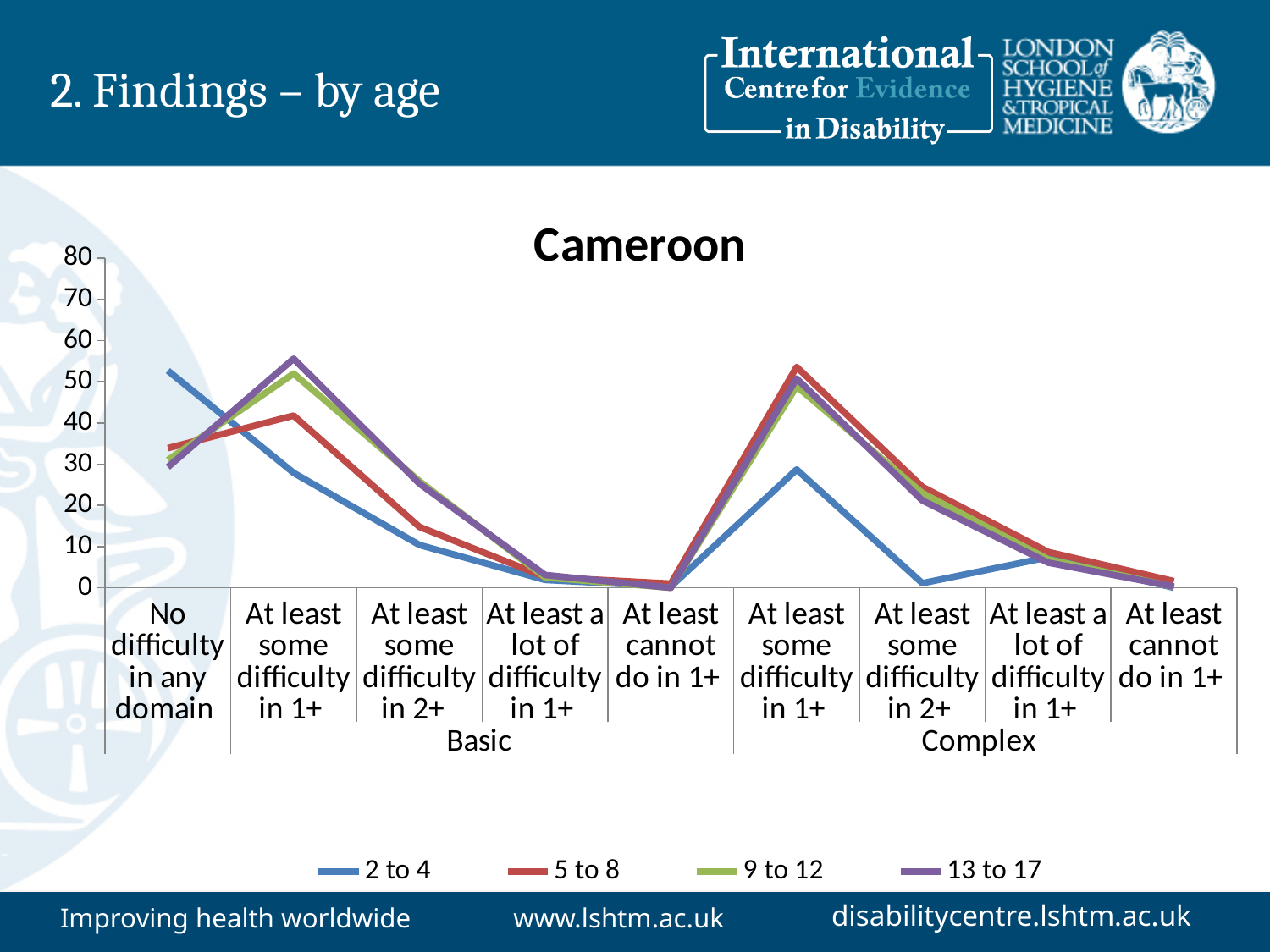
What are the two groupings labelled beneath the x-axis categories? Basic and Complex What is the title of the chart? Cameroon Which age group has the highest value at "No difficulty in any domain"? 2 to 4 Is the value for the 13 to 17 age group at "At least some difficulty in 1+" under Basic greater or less than 50? greater How many categories are shown along the x axis? 9 Which age group has the lowest value at "At least some difficulty in 1+" under Basic? 2 to 4 Is the value for the 5 to 8 age group at "At least some difficulty in 1+" under Complex greater or less than 40? greater Is the value for the 2 to 4 age group at "At least some difficulty in 1+" under Complex greater or less than 40? less How many age-group series does the legend list? 4 At "At least some difficulty in 2+" under Complex, which is larger: the 2 to 4 age group or the 5 to 8 age group? 5 to 8 What kind of chart is shown on the slide? line chart